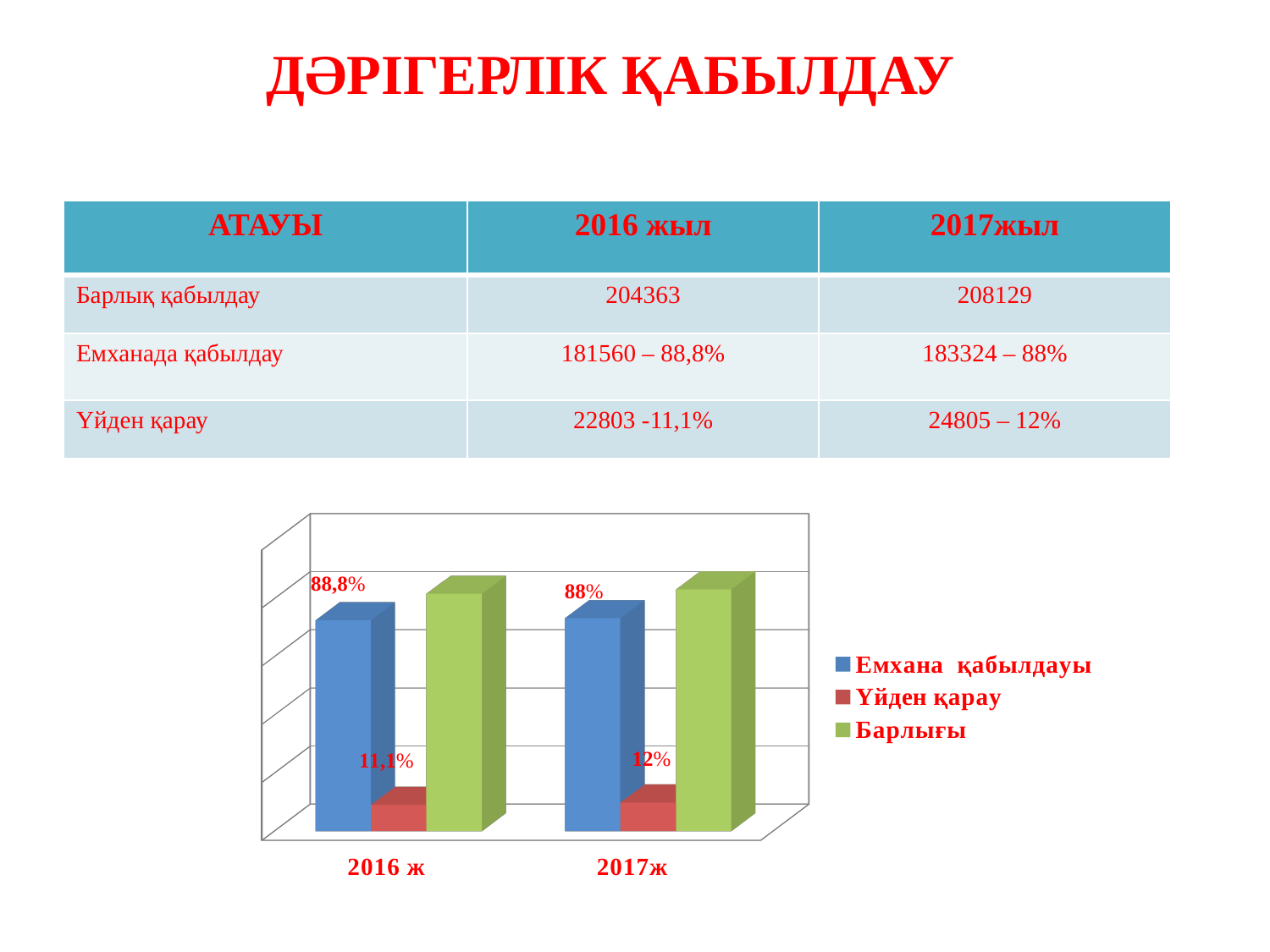
What is the value labelled for Емхана қабылдауы in 2017ж? 88% How many categories are shown on the x axis of the chart? 2 What is the value labelled for Емхана қабылдауы in 2016 ж? 88,8% What type of chart is shown on the slide? bar chart What is the value labelled for Үйден қарау in 2016 ж? 11,1% Which series has the tallest bar in 2016 ж? Барлығы Which is larger: Емхана қабылдауы in 2016 ж or Үйден қарау in 2016 ж? Емхана қабылдауы in 2016 ж Does the Үйден қарау value rise or fall from 2016 ж to 2017ж? rise Which series has the lowest bar in 2017ж? Үйден қарау How many series does the chart legend list? 3 What is the value labelled for Үйден қарау in 2017ж? 12% What colour are the Барлығы bars in the chart? green